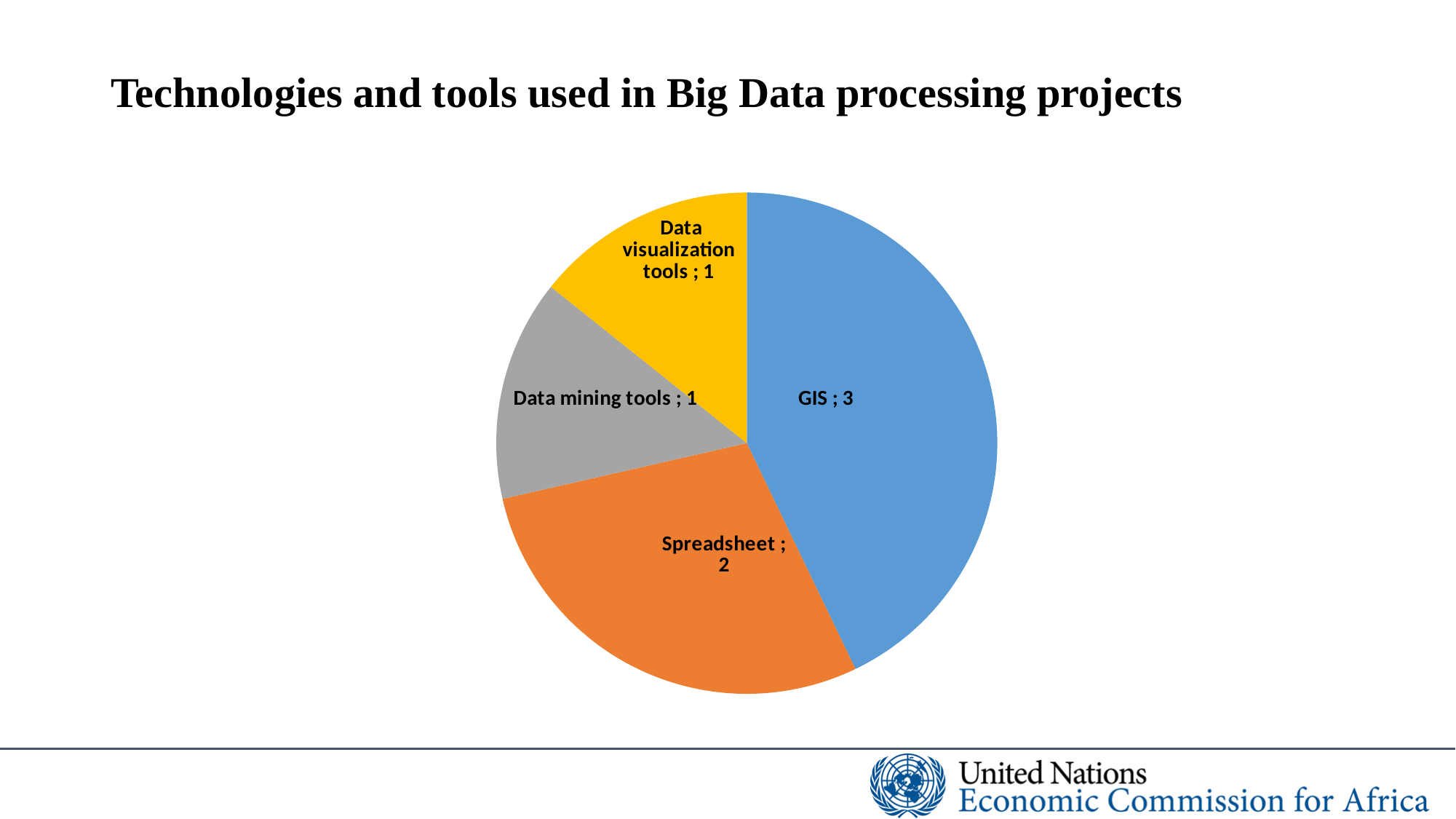
What is the value for Data mining tools? 1 What colour is the GIS slice? blue What is the total of all slices in the pie chart? 7 Which category has the largest slice? GIS What is the value for Data visualization tools? 1 What is the value for Spreadsheet? 2 Which is larger, the value for Spreadsheet or the value for Data mining tools? Spreadsheet What is the value for GIS? 3 What is the title of the slide? Technologies and tools used in Big Data processing projects What kind of chart is shown on the slide? pie chart What is the difference between the values for GIS and Spreadsheet? 1 How many slices does the pie chart have? 4